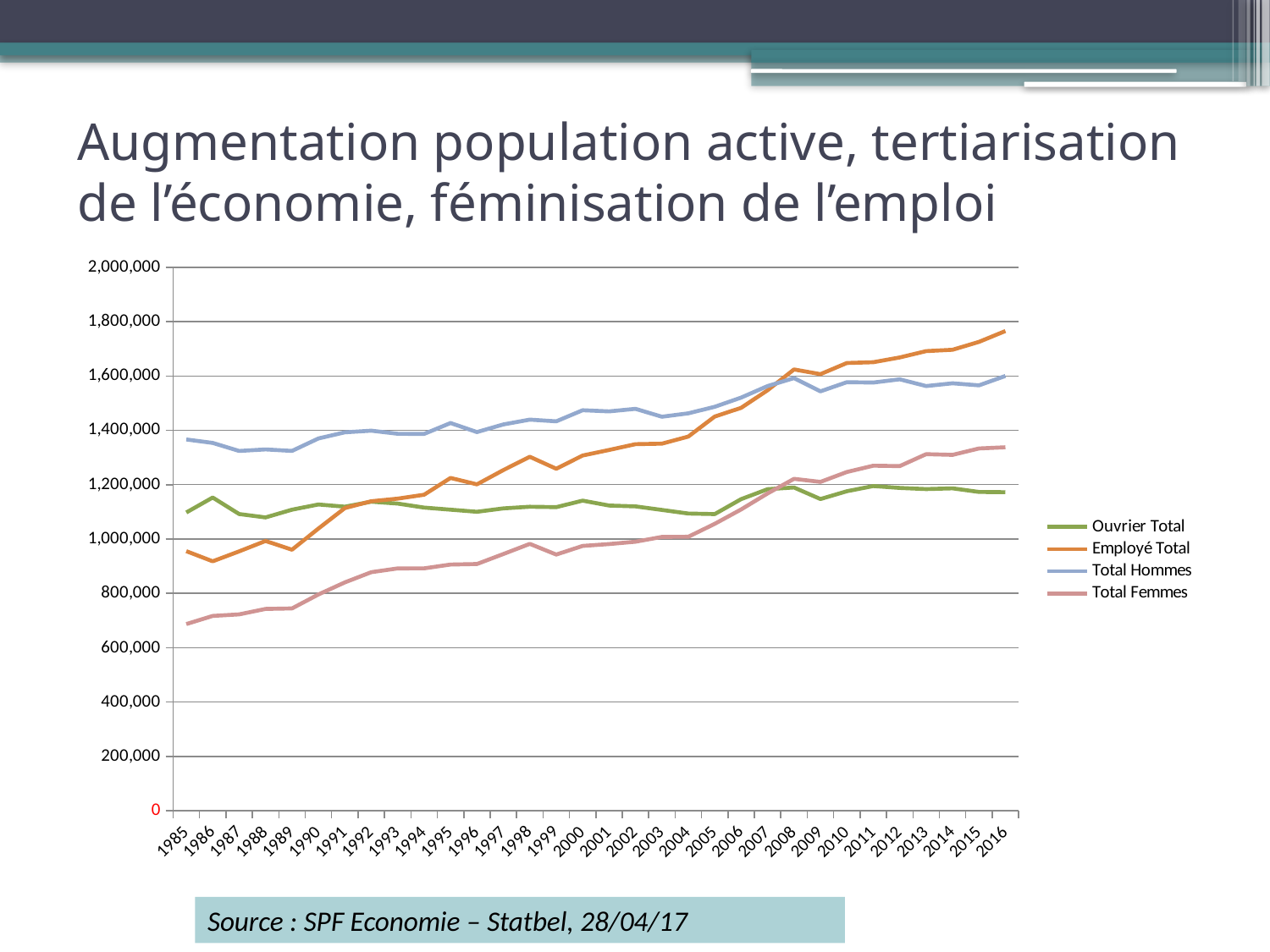
How many years are shown along the x axis? 32 What source is cited below the chart? SPF Economie – Statbel, 28/04/17 Is the value for Employé Total in 2016 greater or less than 1,600,000? greater In 2016, which is larger: Employé Total or Ouvrier Total? Employé Total Is the value for Total Hommes in 1985 greater or less than 1,200,000? greater Which series has the lowest value in 1985? Total Femmes Is the value for Ouvrier Total in 2016 greater or less than 1,400,000? less What kind of chart is shown on the slide? line chart Does the Total Femmes series generally rise or fall from 1985 to 2016? rise How many series does the legend list? 4 Which series has the highest value in 2016? Employé Total